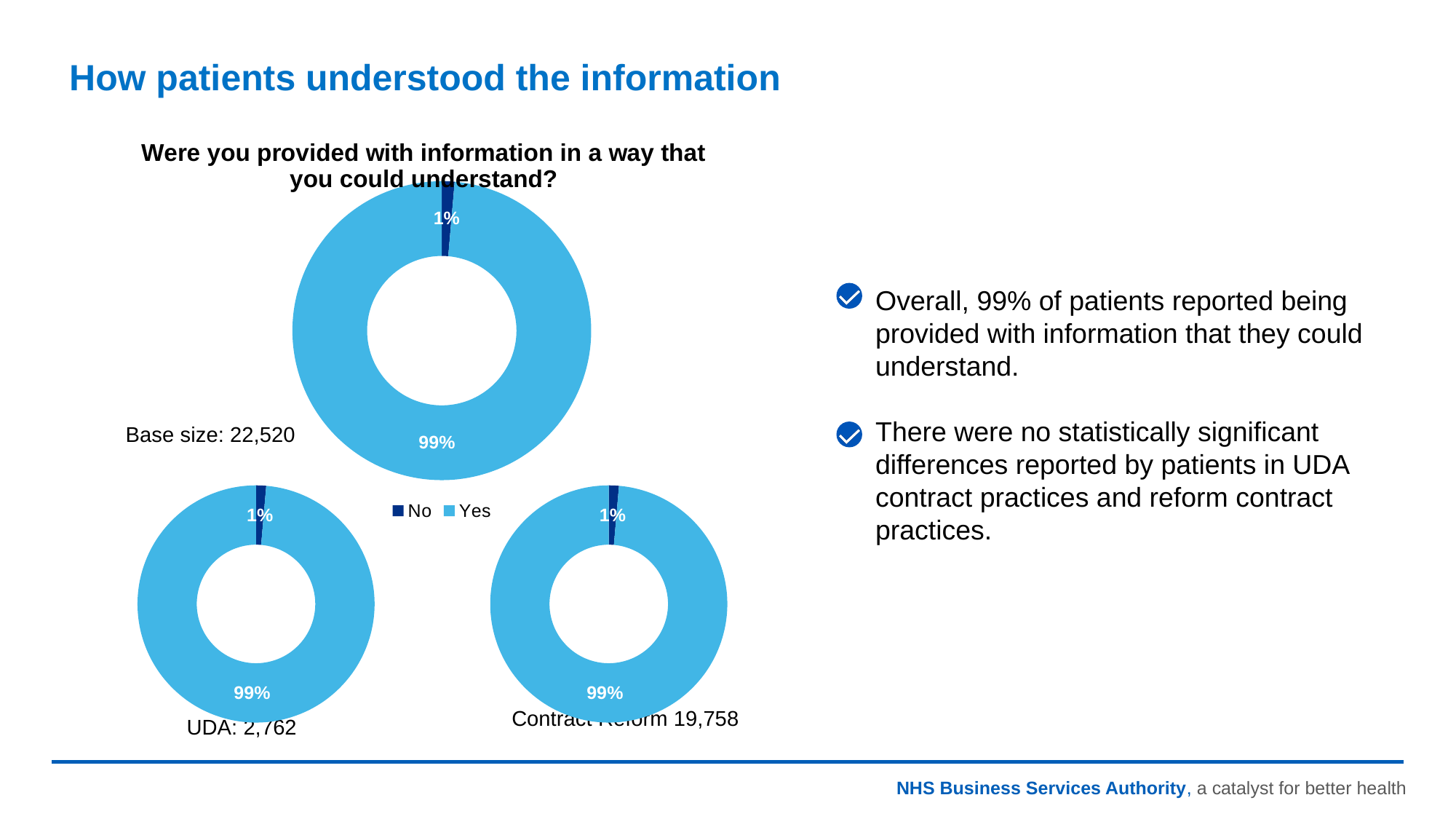
In the bottom-right doughnut chart (Contract Reform), is the Yes slice larger or smaller than the No slice? larger In the bottom-right doughnut chart (Contract Reform 19,758), what percentage answered No? 1% In the bottom-left doughnut chart (UDA), which response is the smallest slice? No What type of chart is used on this slide? Doughnut (pie) chart How many series does the legend list? 2 How many doughnut charts are shown on the slide? 3 In the top doughnut chart, what is the difference between the Yes and No percentages? 98% In the top doughnut chart (Base size: 22,520), what percentage of patients answered No? 1% What is the title of the chart on the slide? Were you provided with information in a way that you could understand? In the top doughnut chart (Base size: 22,520), what percentage of patients answered Yes? 99% In the bottom-left doughnut chart (UDA: 2,762), what percentage answered Yes? 99% In the top doughnut chart, which response is the largest slice? Yes